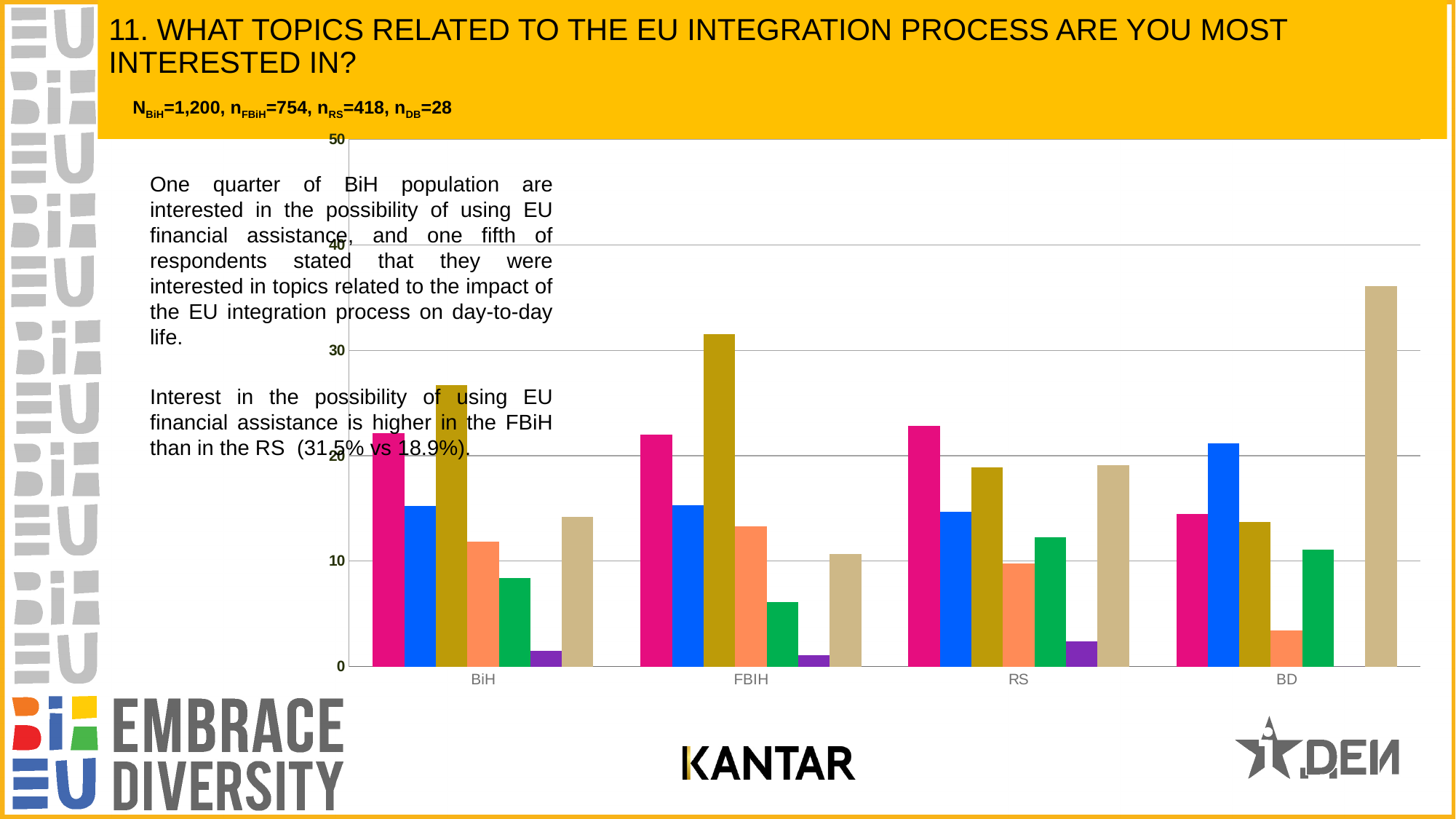
How many categories are shown along the x axis of the chart? 4 Which coloured bar is the tallest in the FBIH group? the dark gold bar Is the value of the tan bar for BiH greater or less than 10? greater What kind of chart is shown on the slide? bar chart What is the highest value shown on the chart's vertical axis? 50 Is the value of the purple bar for BiH greater or less than 10? less Is the value of the tan bar for BD greater or less than 30? greater Is the tan bar larger for BD or for BiH? BD Which category is listed first on the x axis of the chart? BiH Which coloured bar is the tallest in the BD group? the tan bar